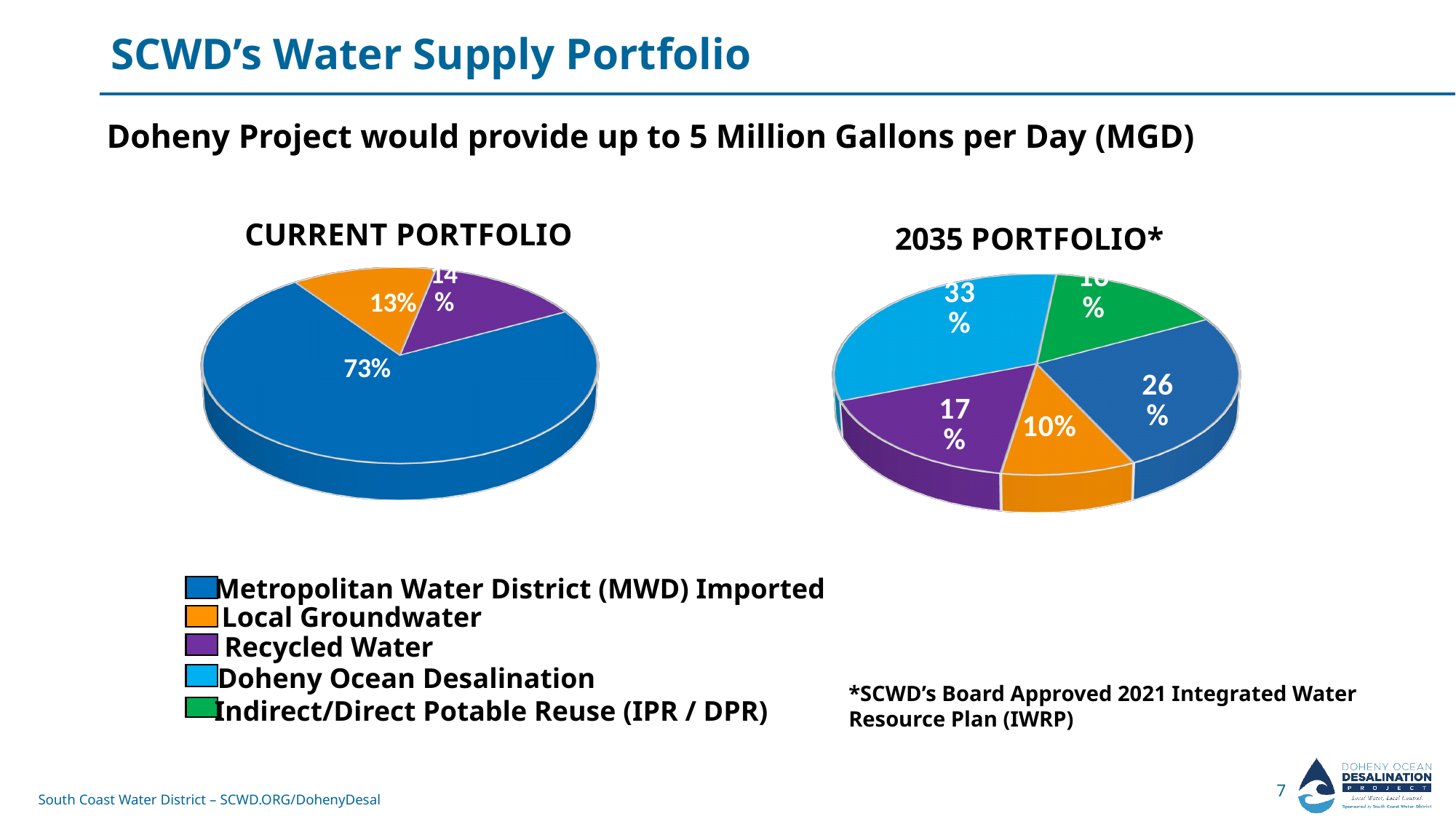
In the Current Portfolio pie chart, what share is Local Groundwater? 13% In the Current Portfolio pie chart, which source has the largest share? Metropolitan Water District (MWD) Imported In the 2035 Portfolio pie chart, what share is Local Groundwater? 10% In the Current Portfolio pie chart, how many percentage points larger is the MWD Imported share than the Local Groundwater share? 60 percentage points In the Current Portfolio pie chart, what share is Metropolitan Water District (MWD) Imported? 73% What type of chart is used for the Current Portfolio? Pie chart Is the MWD Imported share larger in the Current Portfolio chart or in the 2035 Portfolio chart? Current Portfolio In the 2035 Portfolio pie chart, what share is Recycled Water? 17% In the 2035 Portfolio pie chart, which source has the largest share? Doheny Ocean Desalination In the 2035 Portfolio pie chart, what share is Doheny Ocean Desalination? 33% How many slices does the 2035 Portfolio pie chart have? 5 In the 2035 Portfolio pie chart, what share is Metropolitan Water District (MWD) Imported? 26%